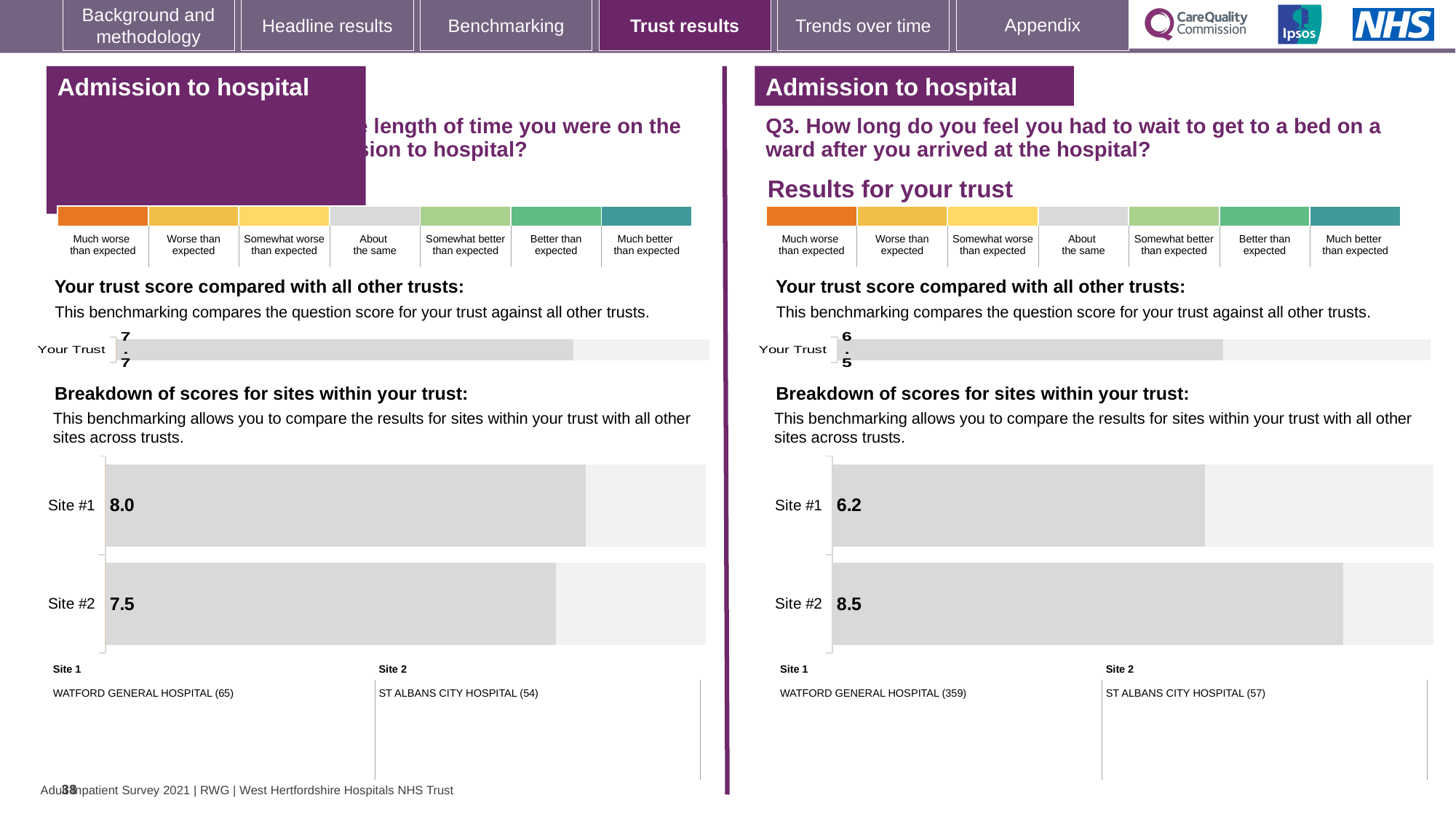
On the right-hand 'Your trust score compared with all other trusts' chart for Q3, what is the score for Your Trust? 6.5 On the left-hand site breakdown chart, what is the score for Site #1? 8.0 On the left-hand site breakdown chart, what is the score for Site #2? 7.5 On the left-hand 'Your trust score compared with all other trusts' chart, what is the score for Your Trust? 7.7 What kind of chart is used for the site breakdown on the right-hand side of the slide? Bar chart On the right-hand chart for Q3, which site has the higher score? Site #2 How many sites are shown in the right-hand site breakdown chart for Q3? 2 On the left-hand site breakdown chart, which site has the lower score? Site #2 On the left-hand site breakdown chart, what is the difference between the Site #1 and Site #2 scores? 0.5 On the right-hand chart for Q3 (wait to get to a bed on a ward), what is the score for Site #1? 6.2 On the right-hand chart for Q3 (wait to get to a bed on a ward), what is the score for Site #2? 8.5 On the right-hand chart for Q3, what is the difference between the Site #2 and Site #1 scores? 2.3